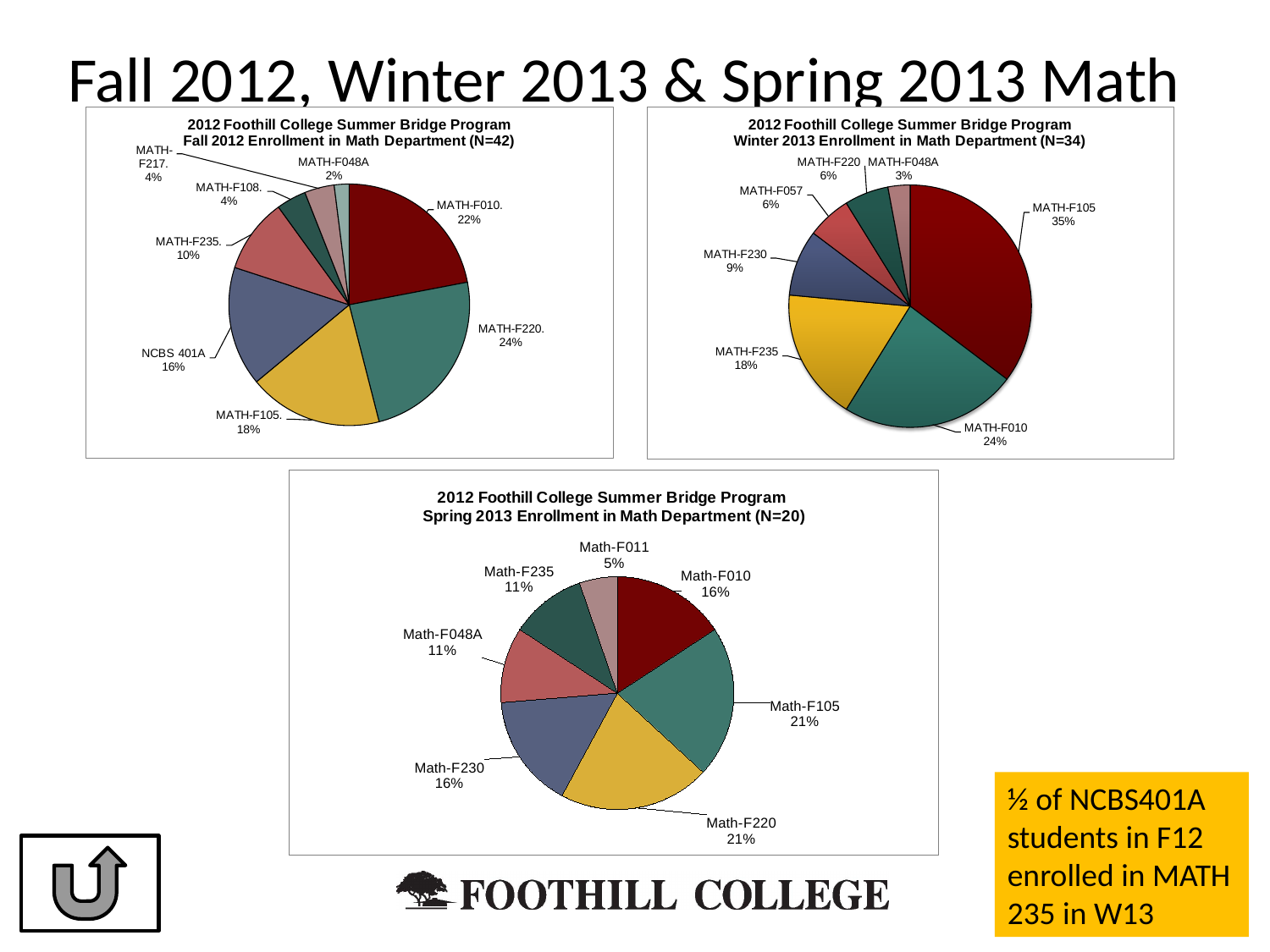
In the Fall 2012 Enrollment chart, what share of enrollment is MATH-F220? 24% In the Winter 2013 Enrollment chart, how many courses are shown? 7 In the Winter 2013 Enrollment chart, what is the difference between the shares of MATH-F105 and MATH-F010? 11% According to the Spring 2013 Enrollment chart title, what is the value of N? 20 In the Spring 2013 Enrollment chart, what share of enrollment is Math-F230? 16% What kind of chart is the Spring 2013 Enrollment chart? Pie chart In the Winter 2013 Enrollment chart, what share of enrollment is MATH-F105? 35% In the Fall 2012 Enrollment chart, which course has the largest share? MATH-F220 In the Winter 2013 Enrollment chart, which is larger, the share of MATH-F235 or the share of MATH-F230? MATH-F235 In the Fall 2012 Enrollment chart, which course has the smallest share? MATH-F048A In the Fall 2012 Enrollment chart, how many slices does the pie have? 8 In the Spring 2013 Enrollment chart, which course has the smallest share? Math-F011